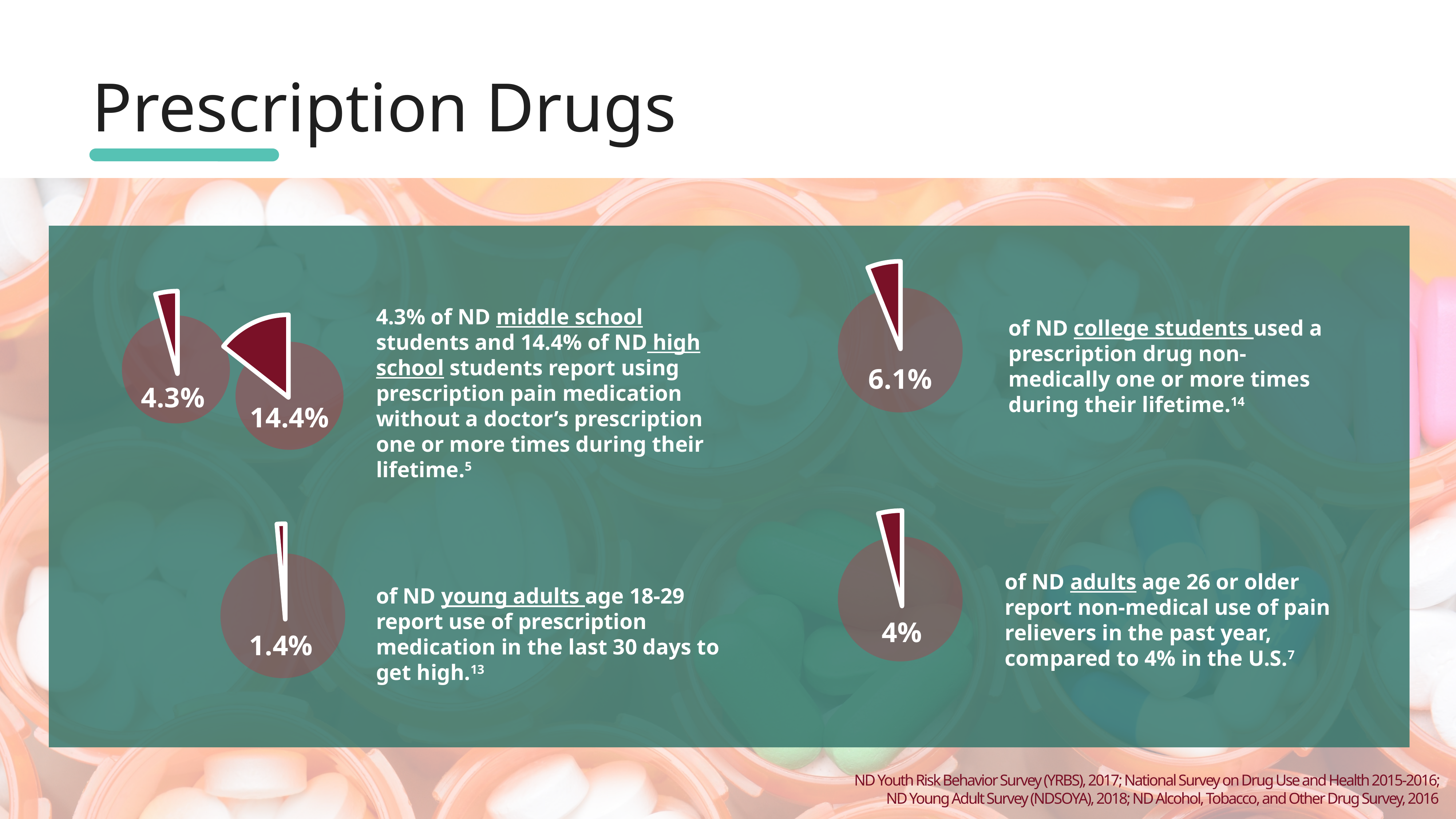
What colour is the highlighted slice in each pie chart? Dark red What percentage of ND middle school students report using prescription pain medication without a doctor's prescription, as shown in the pie chart? 4.3% How many pie charts are shown on the slide? 5 What percentage is shown on the pie chart for ND adults age 26 or older? 4% What percentage is shown on the pie chart for ND college students who used a prescription drug non-medically? 6.1% What value is shown on the pie chart for ND high school students? 14.4% Which group has the highest percentage among the pie charts on the slide? High school students Which is larger: the percentage for college students or the percentage for adults age 26 or older? College students What value does the pie chart for ND young adults age 18-29 show? 1.4% Which group has the lowest percentage among the pie charts on the slide? Young adults age 18-29 What kind of chart is used to display the percentages on this slide? Pie chart What is the difference between the high school students' percentage and the middle school students' percentage? 10.1%